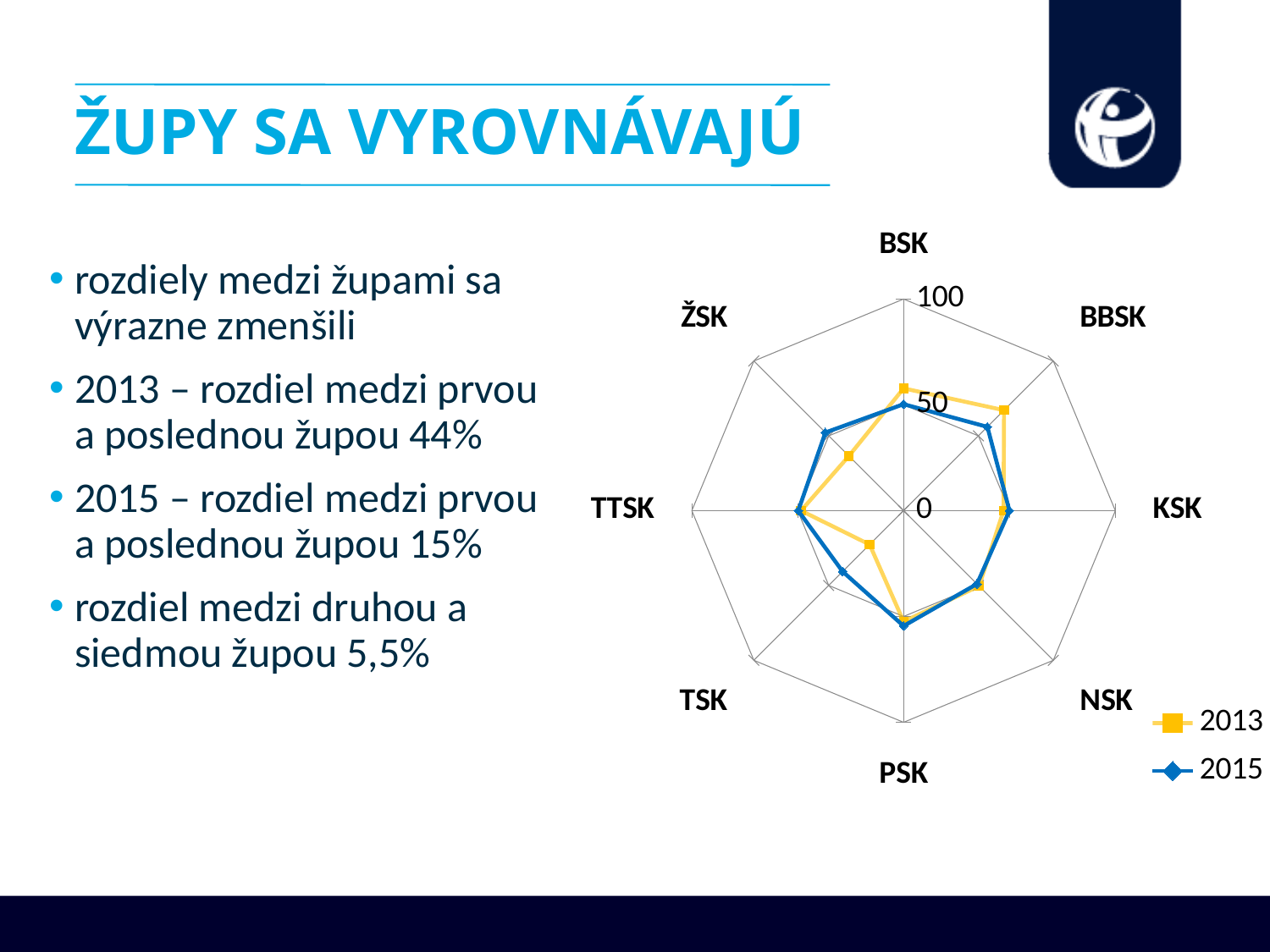
Which series are listed in the legend of the radar chart? 2013 and 2015 Which region has the highest value in the 2013 series? BBSK What kind of chart is shown on the slide? Radar chart Which region has the lowest value in the 2013 series? TSK Is the 2013 value for ŽSK greater or less than 50? less Is the 2013 value for TSK greater or less than 50? less How many series does the legend of the radar chart list? 2 Is the 2013 value for BBSK greater or less than 50? greater What colour is used for the 2013 series on the radar chart? Yellow How many categories (regions) are plotted on the radar chart? 8 For BBSK, which series has the larger value, 2013 or 2015? 2013 For TSK, which series has the larger value, 2013 or 2015? 2015